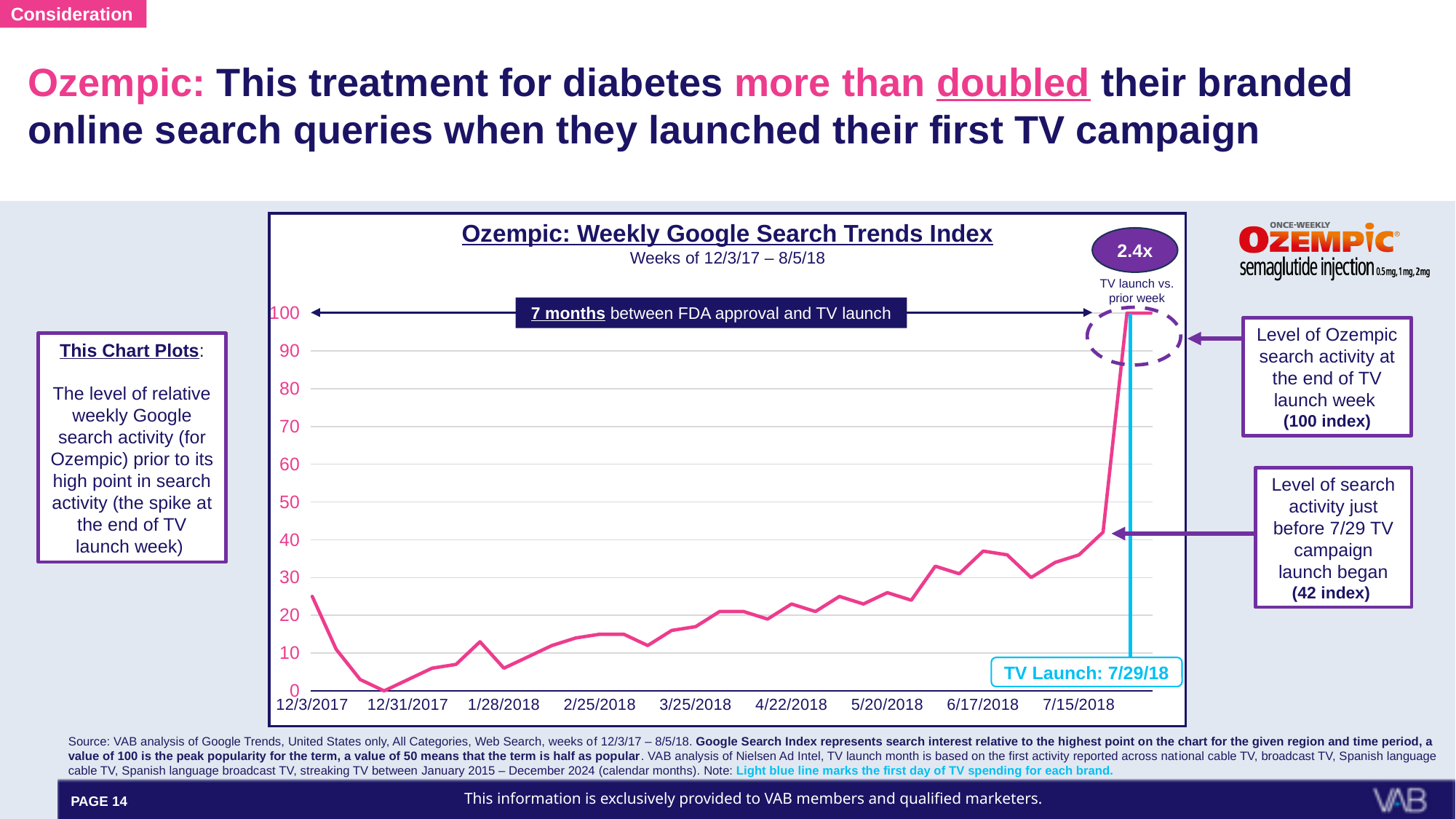
Which labeled week on the x axis has the lowest search index value? 12/31/2017 How many date labels are shown on the x axis? 9 What was the Ozempic search index at the end of the TV launch week? 100 Which is larger: the search index just before the TV launch or the search index at the end of TV launch week? end of TV launch week What was the Ozempic search index just before the 7/29 TV campaign launch began? 42 What kind of chart is shown on the slide? line chart On what date did the Ozempic TV launch occur, according to the chart? 7/29/18 Is the search index value for the week of 6/17/2018 greater or less than 30? greater Overall, does the search index rise or fall from 12/3/2017 to the end of the chart? rise Is the search index value for the week of 12/3/2017 greater or less than 30? less By how many index points did the search index rise from just before the TV launch (42) to the end of TV launch week (100)? 58 Is the search index value for the week of 12/31/2017 greater or less than 10? less